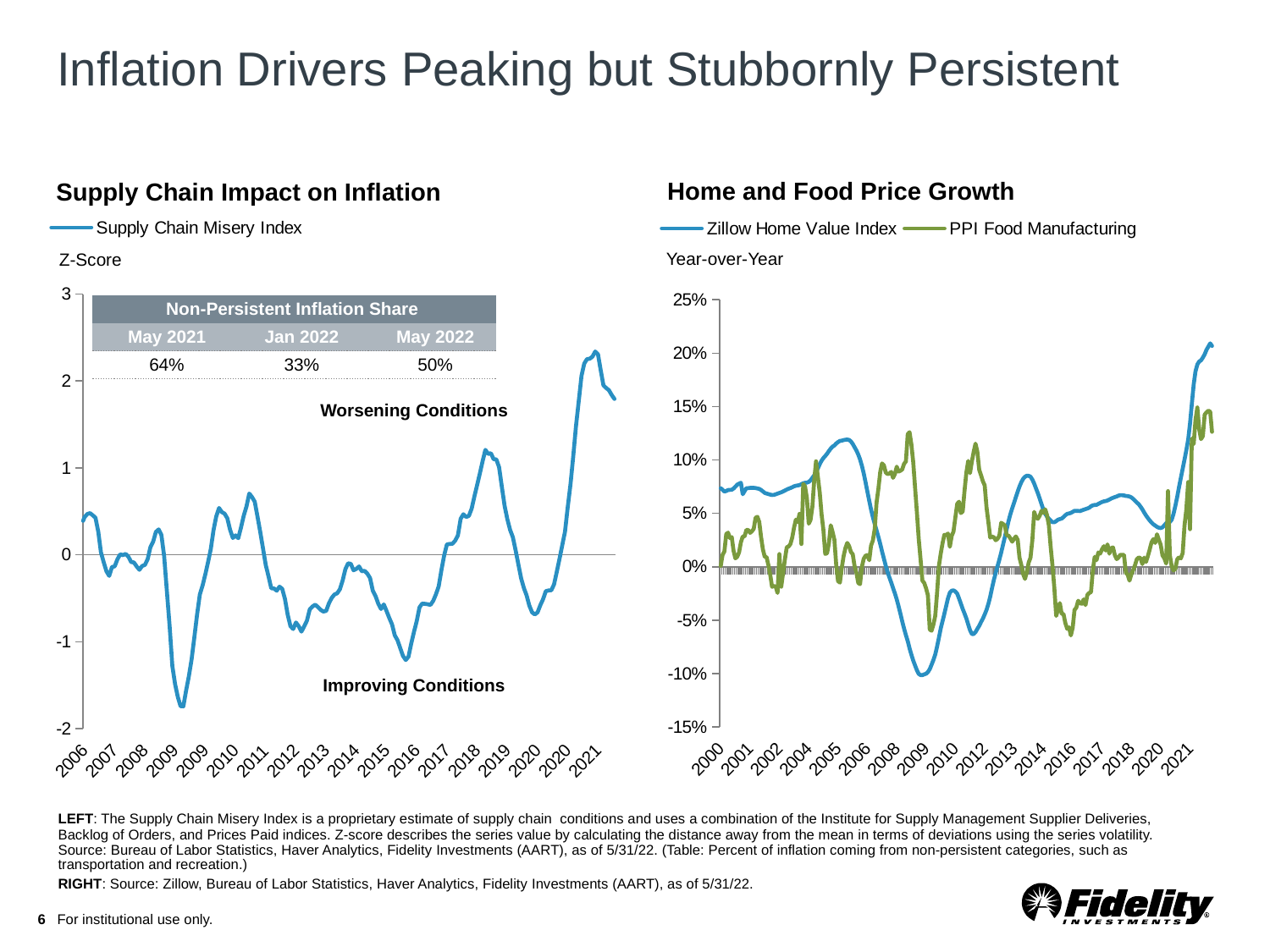
In the 'Supply Chain Impact on Inflation' chart's inset table, what is the difference between the May 2021 and Jan 2022 Non-Persistent Inflation Share values? 31 percentage points In the 'Home and Food Price Growth' chart, is the lowest value of the Zillow Home Value Index around 2009 greater or less than -5%? less In the 'Home and Food Price Growth' chart, which series reaches the higher peak in 2021, Zillow Home Value Index or PPI Food Manufacturing? Zillow Home Value Index In the 'Home and Food Price Growth' chart, which series is shown in green? PPI Food Manufacturing How many series does the legend of the 'Home and Food Price Growth' chart list? 2 In the 'Supply Chain Impact on Inflation' chart's inset table, which date has the lowest Non-Persistent Inflation Share? Jan 2022 In the 'Supply Chain Impact on Inflation' chart, what is the Non-Persistent Inflation Share for Jan 2022 in the inset table? 33% In the 'Supply Chain Impact on Inflation' chart, is the peak value of the Supply Chain Misery Index in 2021 greater or less than 2? greater In the 'Supply Chain Impact on Inflation' chart, is the lowest value of the Supply Chain Misery Index around 2009 greater or less than -1? less What type of chart is the 'Supply Chain Impact on Inflation' chart? Line chart In the 'Supply Chain Impact on Inflation' chart, what is the Non-Persistent Inflation Share for May 2021 in the inset table? 64%